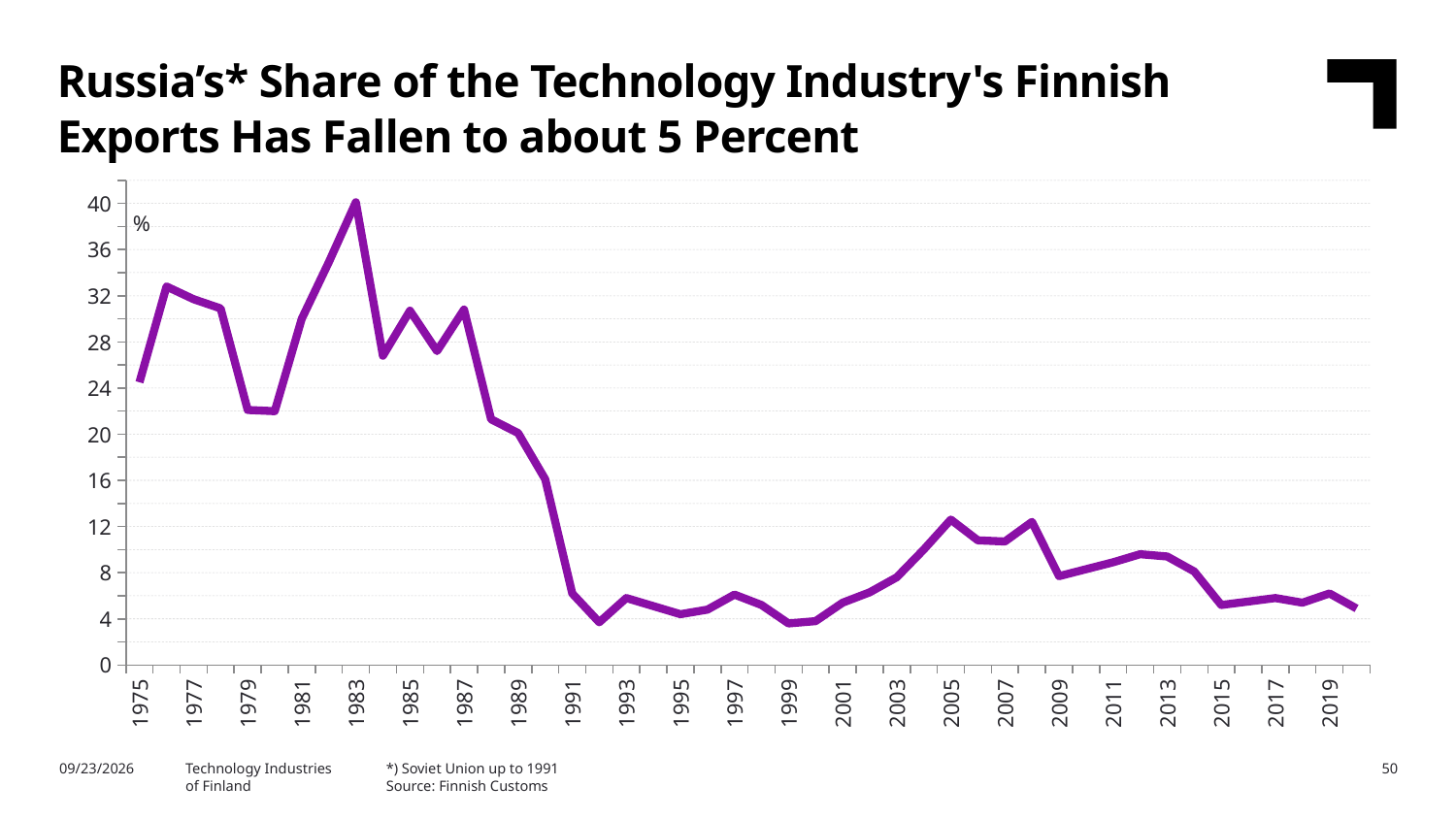
In which year does Russia's share of the technology industry's Finnish exports reach its highest value? 1983 Is the value for 1983 greater or less than 36? greater Is the value for 1979 greater or less than 24? less Is the value for 2005 greater or less than 8? greater What unit is shown on the vertical axis of the chart? % Overall, does Russia's share rise or fall from 1975 to the end of the series? fall What kind of chart is shown on the slide? line chart Which year has the larger value, 1975 or 2019? 1975 Which year has the larger value, 1983 or 2005? 1983 According to the footnote, which entity does the series represent up to 1991? Soviet Union